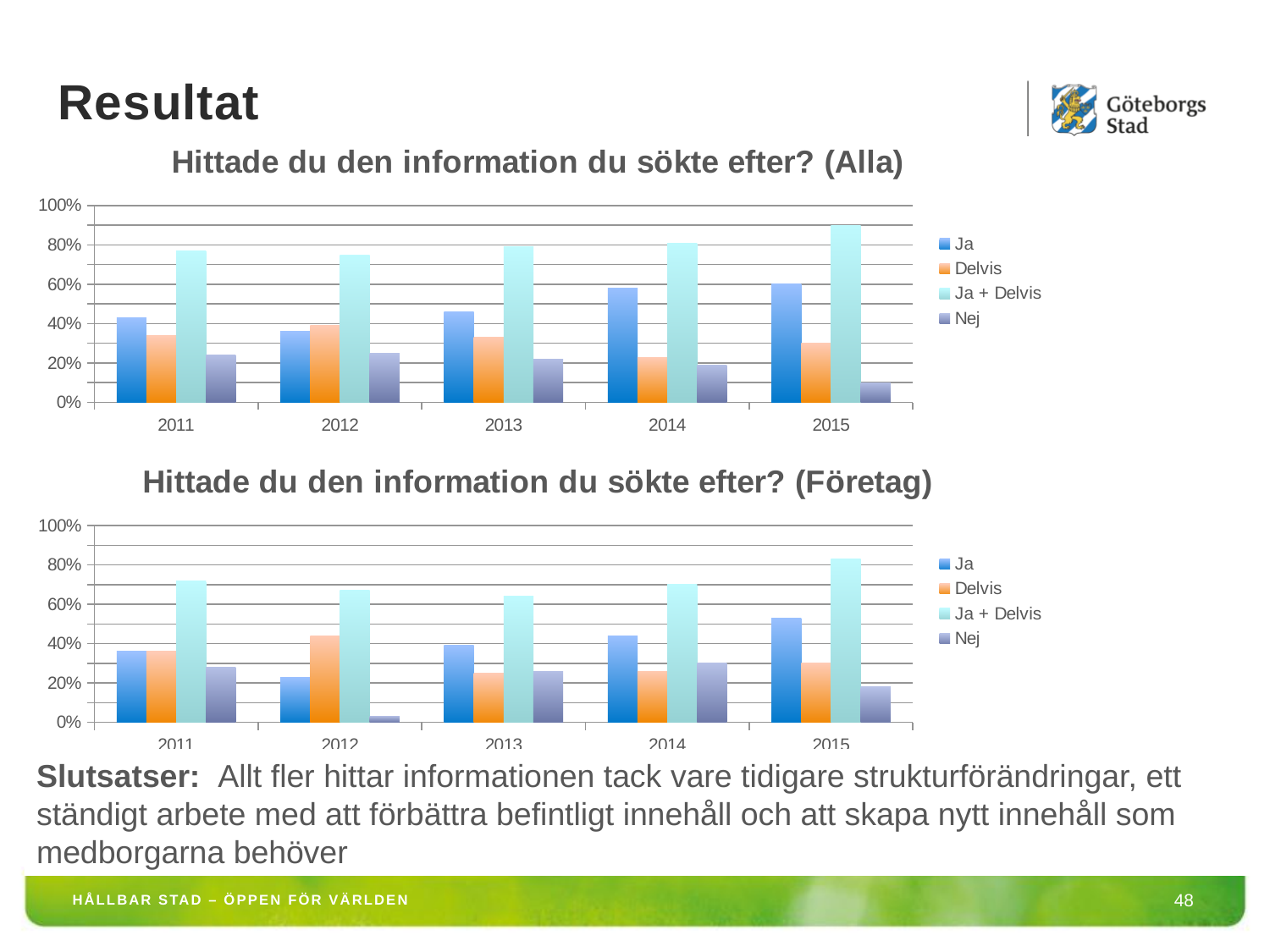
In the bottom chart (Företag), is the value for "Ja" in 2015 greater or less than 40%? greater In the bottom chart (Företag), does the "Ja" series rise or fall from 2012 to 2015? Rise How many years are shown on the x axis of the bottom chart (Företag)? 5 In the bottom chart (Företag), which is larger in 2012: "Ja" or "Delvis"? Delvis In the top chart (Alla), in which year is the "Nej" bar lowest? 2015 What kind of chart is the top chart titled "Hittade du den information du sökte efter? (Alla)"? Bar chart In the top chart (Alla), in which year is the "Ja + Delvis" bar highest? 2015 In the top chart (Alla), is the value for "Ja + Delvis" in 2015 greater or less than 80%? greater In the top chart (Alla), which is larger in 2014: "Ja" or "Delvis"? Ja How many series does the legend of the top chart (Alla) list? 4 In the bottom chart (Företag), in which year is the "Nej" bar lowest? 2012 In the top chart (Alla), is the value for "Nej" in 2015 greater or less than 20%? less